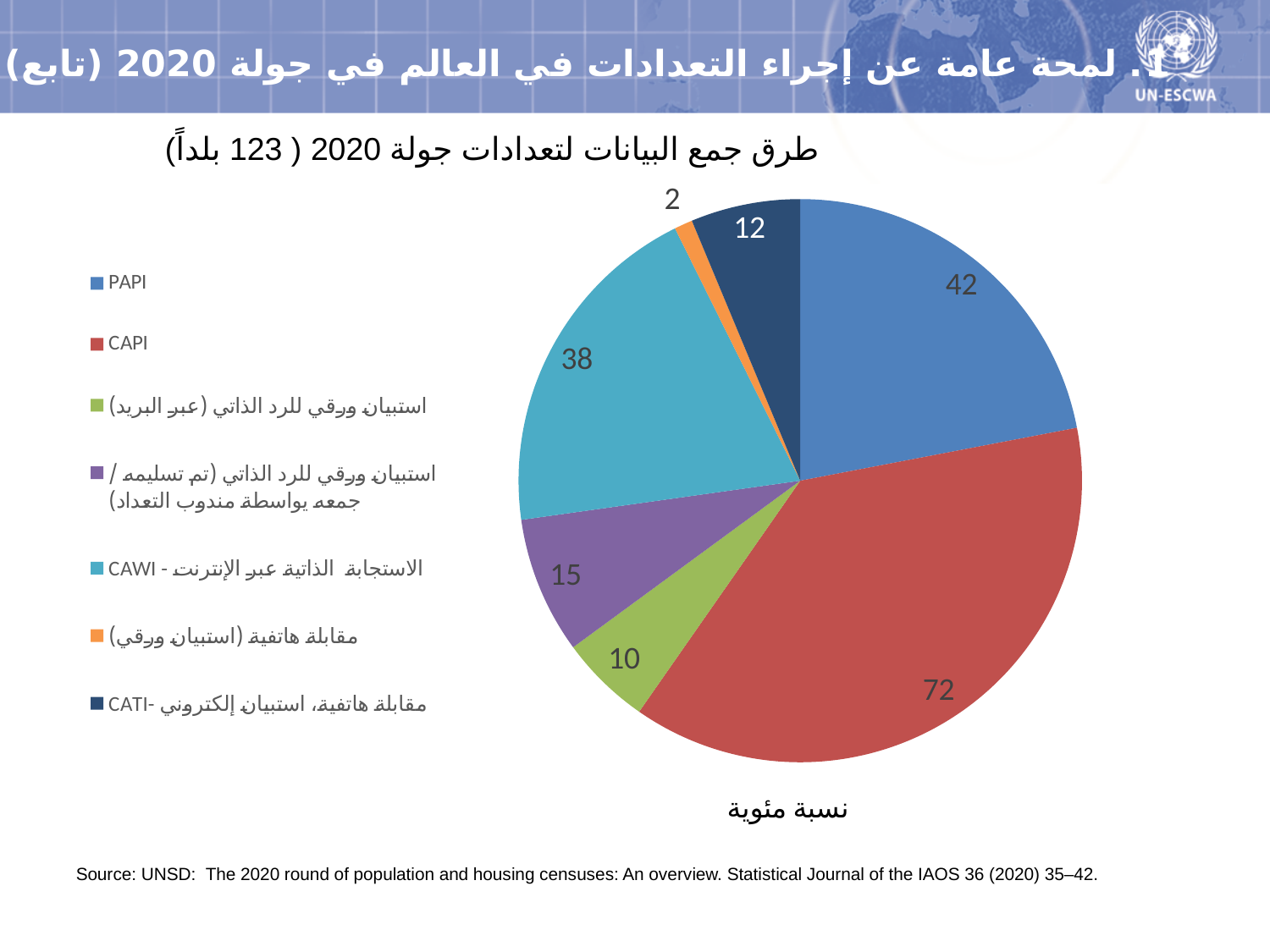
What type of chart is shown on the slide? pie chart What is the value shown for CATI (مقابلة هاتفية، استبيان إلكتروني)? 12 What is the value shown for PAPI? 42 What is the value shown for the telephone interview with paper questionnaire (مقابلة هاتفية (استبيان ورقي))? 2 What is the value shown for the paper self-response questionnaire by mail (استبيان ورقي للرد الذاتي (عبر البريد))? 10 How many slices does the pie chart have? 7 Which data collection method has the smallest slice in the pie chart? مقابلة هاتفية (استبيان ورقي) Which data collection method has the largest slice in the pie chart? CAPI What is the difference between the values for CAPI and PAPI? 30 Which has a larger value, PAPI or CAWI? PAPI What is the value shown for CAPI? 72 What is the value shown for CAWI (الاستجابة الذاتية عبر الإنترنت)? 38